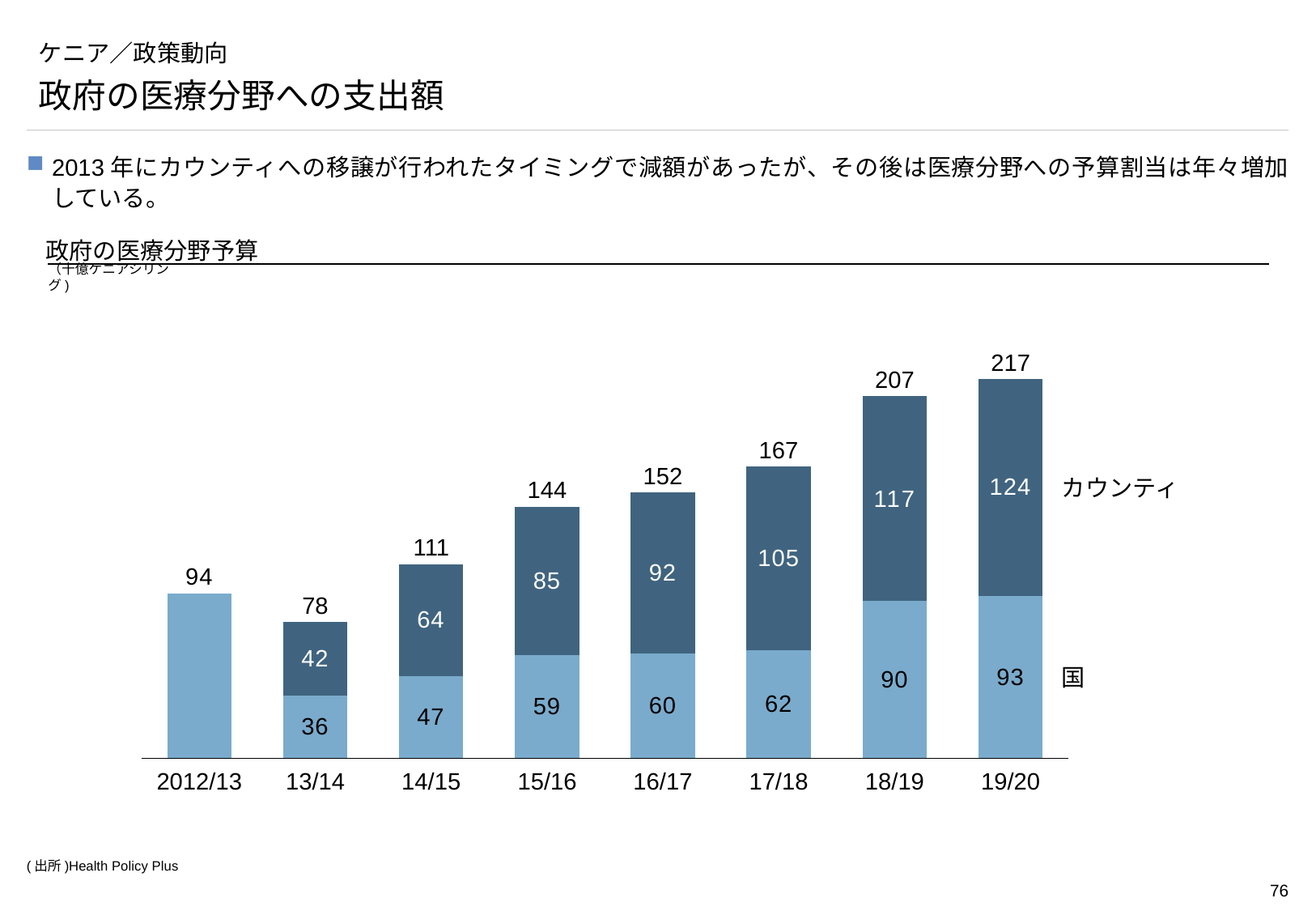
From 13/14 to 19/20, do the total budget values rise or fall? Rise What is the unit stated under the chart title? 十億ケニアシリング What is the 国 (national) value for 14/15? 47 Which fiscal year has the highest total health budget? 19/20 What is the カウンティ (county) value for 17/18? 105 How many series are shown in the stacked bars? 2 How many fiscal years are shown on the x axis? 8 What is the difference between the total budget for 18/19 and 17/18? 40 What kind of chart is this? Stacked bar chart What is the total government health budget for 19/20? 217 Which fiscal year has the lowest total health budget? 13/14 Which is larger in 15/16, the カウンティ value or the 国 value? カウンティ